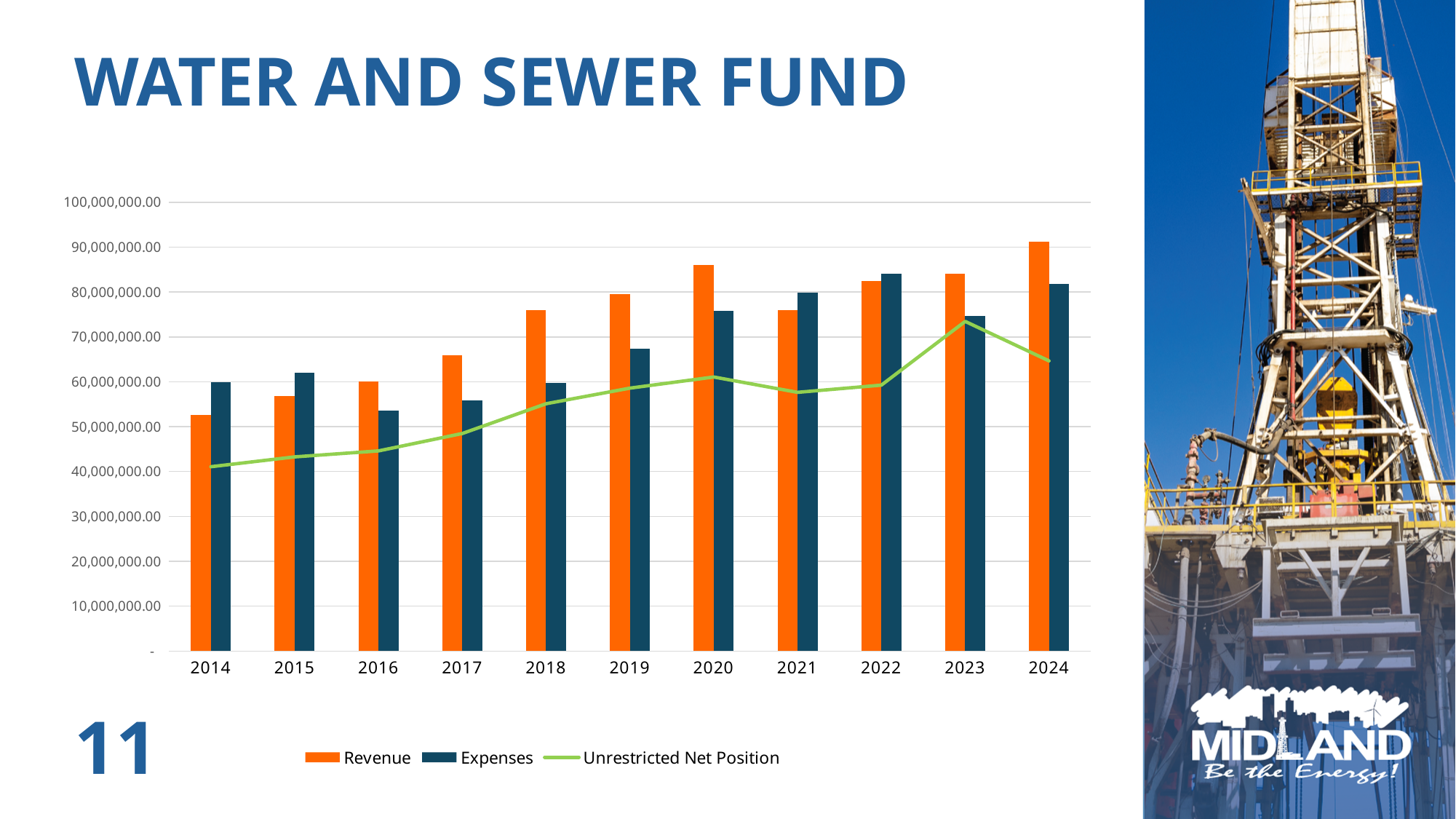
In 2014, which is larger, Revenue or Expenses? Expenses What kind of chart is shown on the slide? A bar chart with a line series Does the Unrestricted Net Position generally rise or fall from 2014 to 2023? rise In which year is the Unrestricted Net Position highest? 2023 Is the Unrestricted Net Position for 2014 greater or less than 50,000,000.00? less In 2020, which is larger, Revenue or Expenses? Revenue In which year are Expenses lowest? 2016 How many series does the legend list? 3 In which year is Revenue highest? 2024 How many years are shown on the x axis? 11 In which year is Revenue lowest? 2014 Is the Revenue value for 2024 greater or less than 80,000,000.00? greater